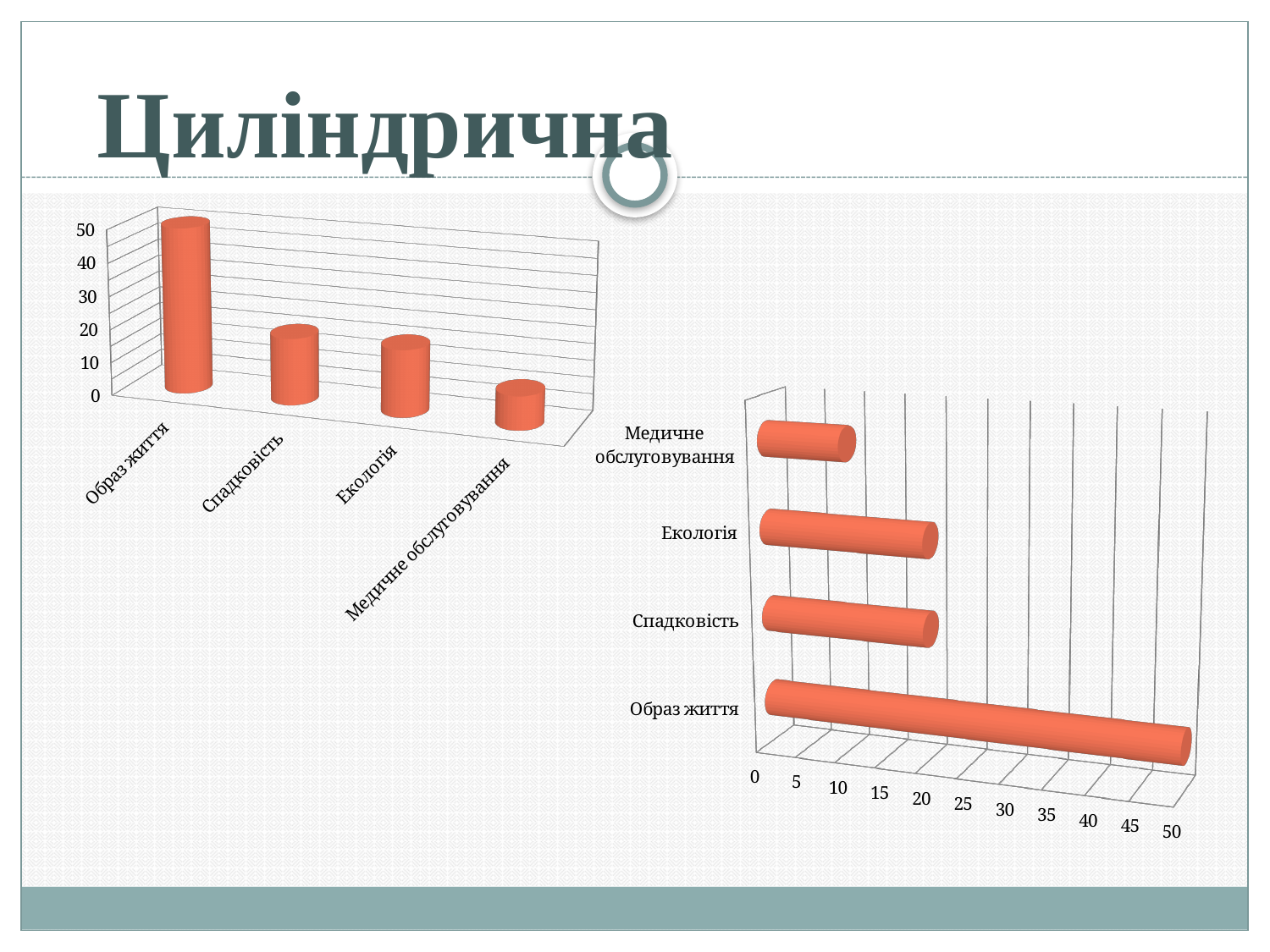
On the left chart, is the value for Образ життя greater or less than 40? greater On the left chart, which category has the lowest value? Медичне обслуговування What is the highest tick value on the value axis of the right chart? 50 On the left chart, is the value for Медичне обслуговування greater or less than 20? less On the right chart, is the value for Спадковість greater or less than 30? less On the right chart, which category has the highest value? Образ життя On the right chart, which is larger, the value for Образ життя or the value for Екологія? Образ життя What is the title of the slide? Циліндрична On the left chart, which category has the highest value? Образ життя What kind of chart is the right chart? bar chart On the right chart, which category has the lowest value? Медичне обслуговування How many categories are shown on the left chart? 4